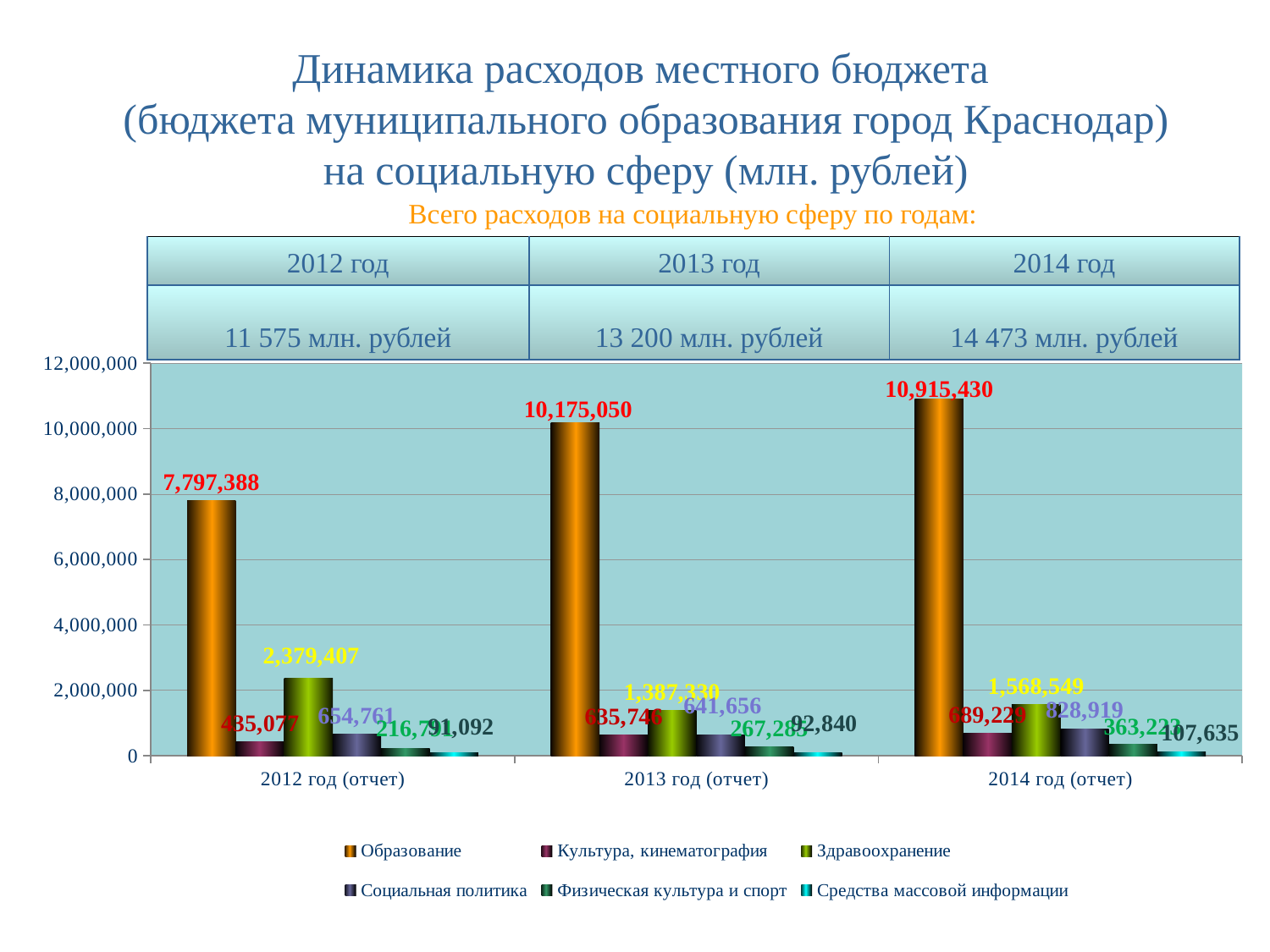
What is the difference between the Образование values for 2014 год (отчет) and 2013 год (отчет)? 740,380 How many year categories are shown on the x axis? 3 What is the value for Образование in 2014 год (отчет)? 10,915,430 Which is larger: Здравоохранение in 2012 год (отчет) or in 2014 год (отчет)? 2012 год (отчет) Do the values for Образование rise or fall from 2012 to 2014? rise In which year is the value for Образование the highest? 2014 год (отчет) What is the value for Культура, кинематография in 2013 год (отчет)? 635,746 What kind of chart is shown on the slide? bar chart What is the value for Социальная политика in 2014 год (отчет)? 828,919 What is the value for Образование in 2012 год (отчет)? 7,797,388 How many series does the legend list? 6 What is the value for Здравоохранение in 2012 год (отчет)? 2,379,407